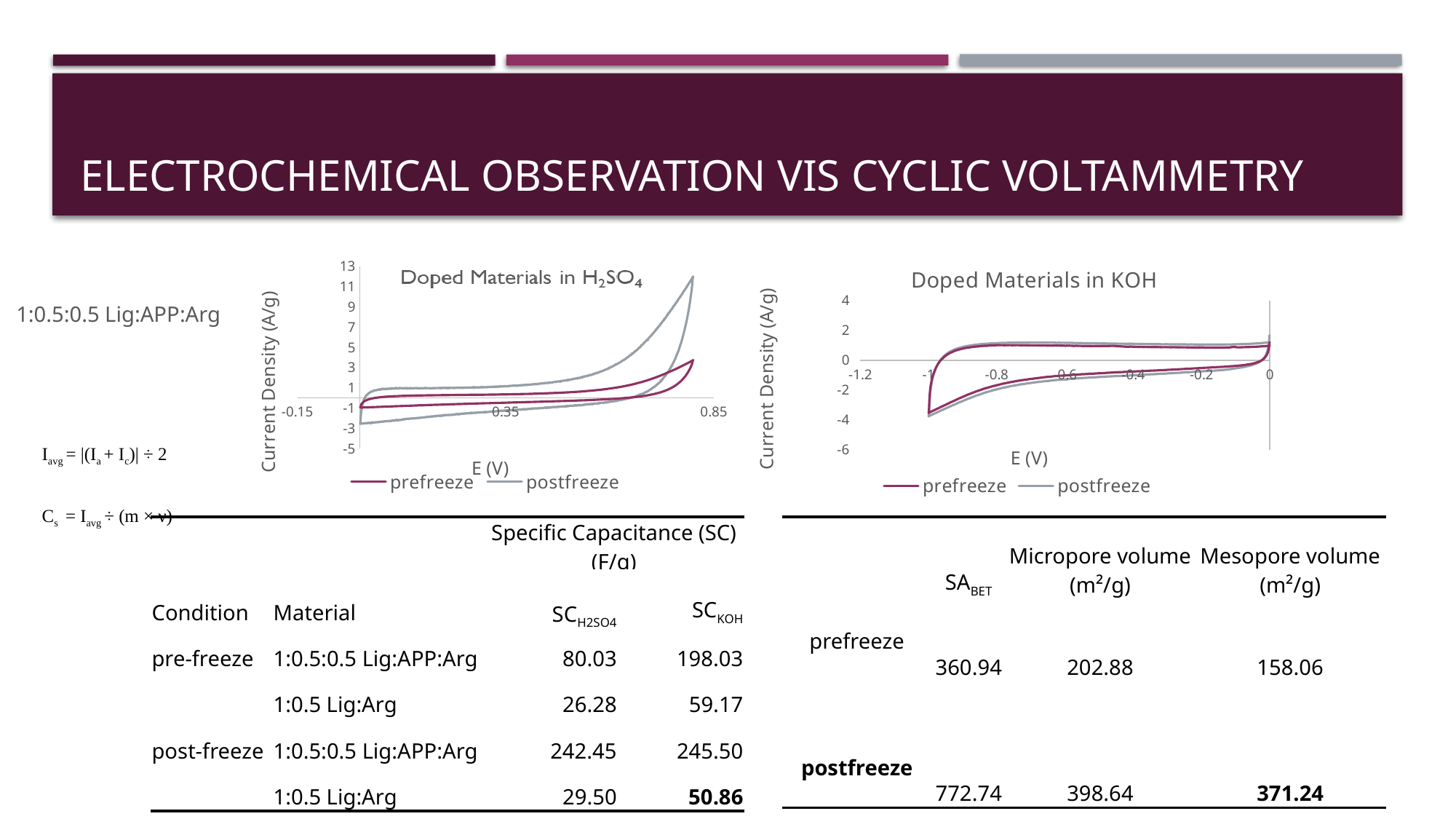
How many series does the legend of the "Doped Materials in H2SO4" chart list? 2 What is the y-axis label of the "Doped Materials in KOH" chart? Current Density (A/g) In the "Doped Materials in H2SO4" chart, which series reaches the higher maximum current density, prefreeze or postfreeze? postfreeze In the "Doped Materials in H2SO4" chart, is the peak current density of the postfreeze series greater or less than 9 A/g? greater What kind of chart is the "Doped Materials in H2SO4" chart? line chart In the "Doped Materials in KOH" chart, is the highest current density reached by either series greater or less than 4 A/g? less How many series does the legend of the "Doped Materials in KOH" chart list? 2 What are the two legend entries of the "Doped Materials in H2SO4" chart? prefreeze and postfreeze What kind of chart is the "Doped Materials in KOH" chart? line chart In the "Doped Materials in KOH" chart, is the lowest current density of the postfreeze series greater or less than -2 A/g? less